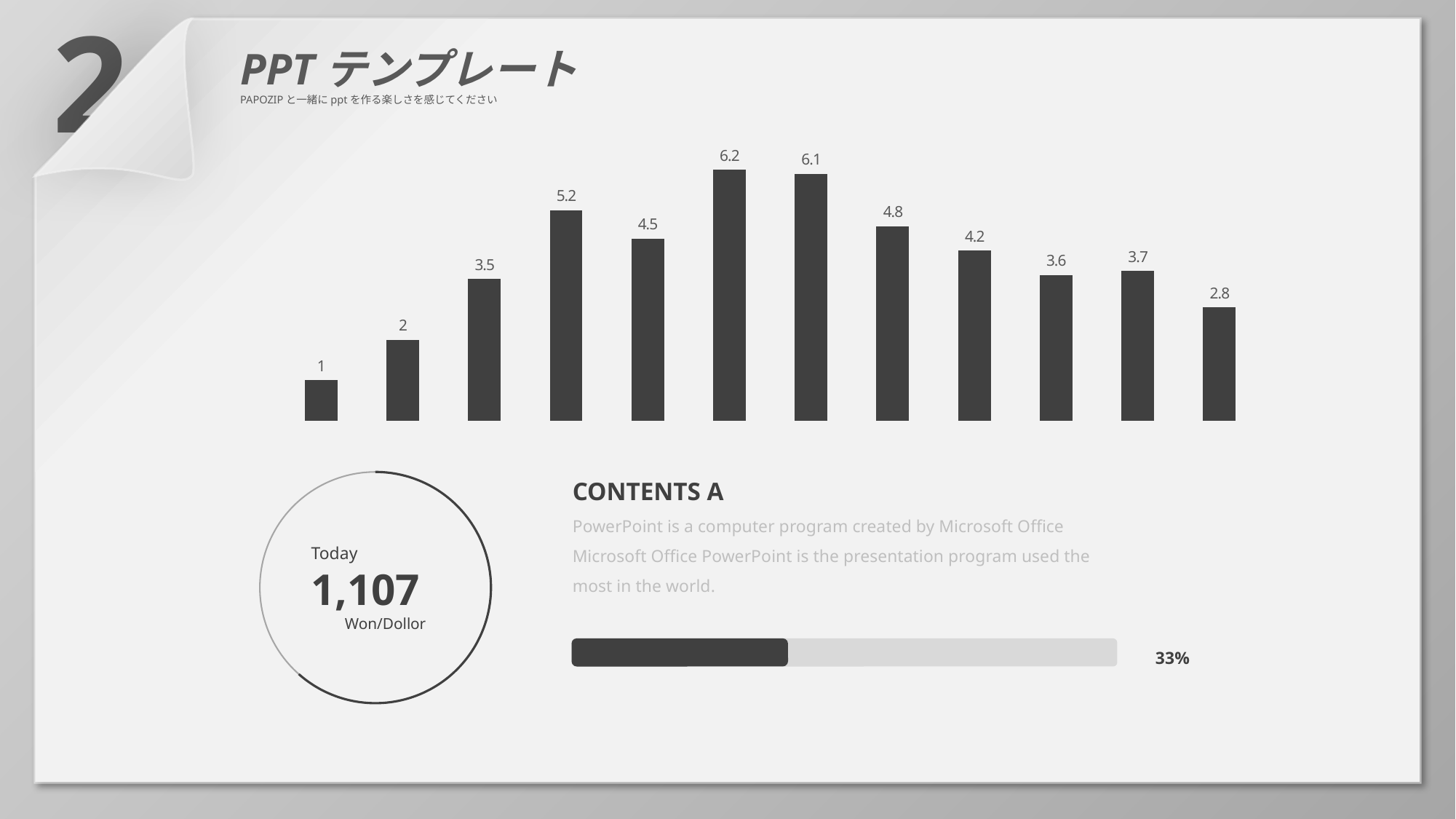
What is the value of the last (rightmost) bar? 2.8 What is the value of the first (leftmost) bar? 1 What is the highest value shown in the chart? 6.2 What is the difference between the highest bar (6.2) and the lowest bar (1)? 5.2 How many bars does the chart contain? 12 Do the values rise or fall from the eighth bar (4.8) to the tenth bar (3.6)? fall What is the lowest value shown in the chart? 1 What kind of chart is shown on the slide? bar chart What is the value of the fourth bar from the left? 5.2 Do the values rise or fall across the first four bars from left to right? rise Which is larger, the sixth bar or the seventh bar? the sixth bar (6.2) What is the difference between the fourth bar (5.2) and the fifth bar (4.5)? 0.7